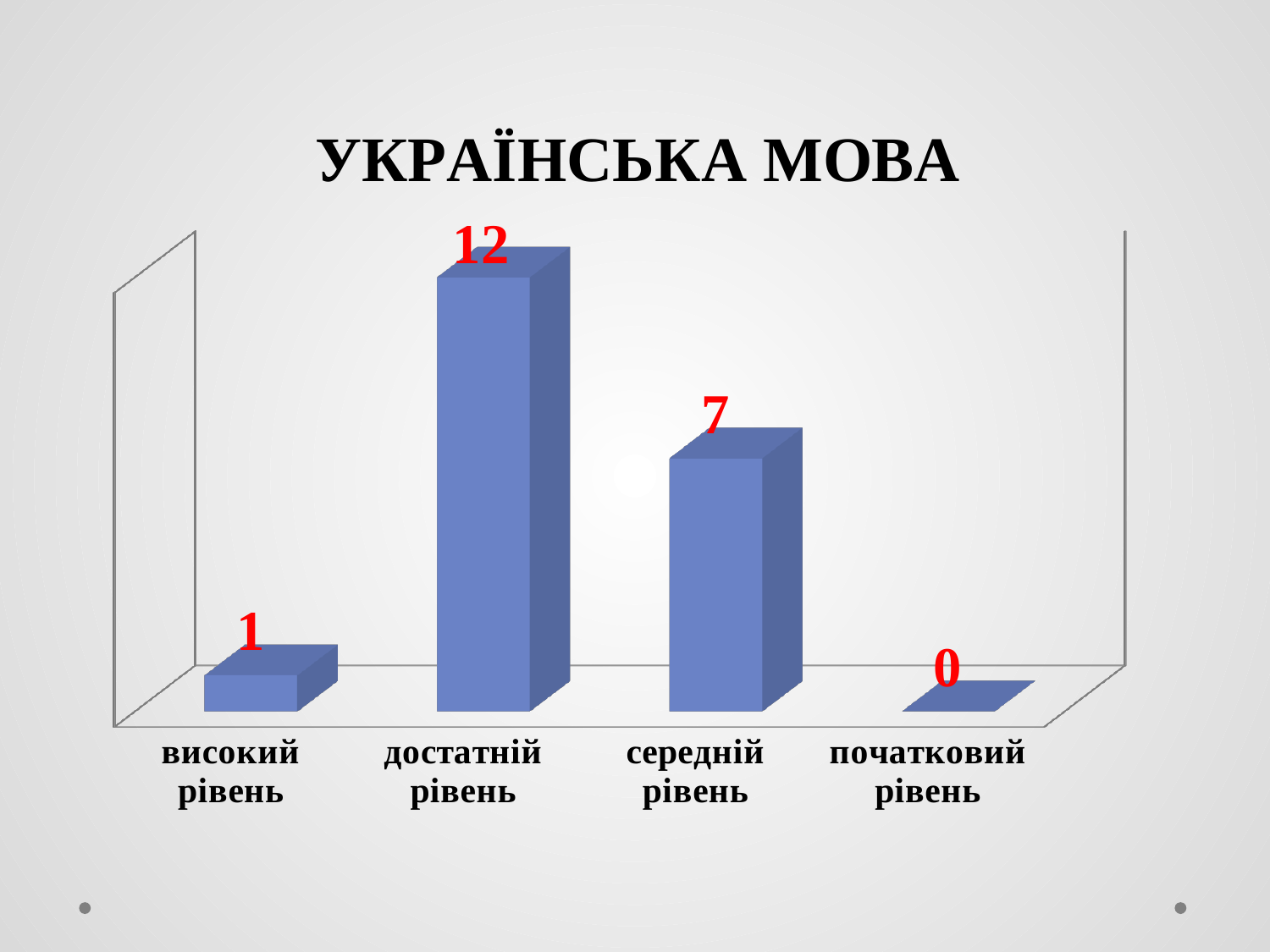
Which category has the highest value? достатній рівень What is the value for середній рівень? 7 What is the difference between the values for достатній рівень and середній рівень? 5 What kind of chart is shown on the slide? bar chart Which is larger, the value for високий рівень or the value for середній рівень? середній рівень How many categories are shown on the x axis? 4 What is the difference between the values for середній рівень and високий рівень? 6 What is the value for початковий рівень? 0 What is the value for достатній рівень? 12 What is the value for високий рівень? 1 Which category has the lowest value? початковий рівень What is the title of the chart? УКРАЇНСЬКА МОВА